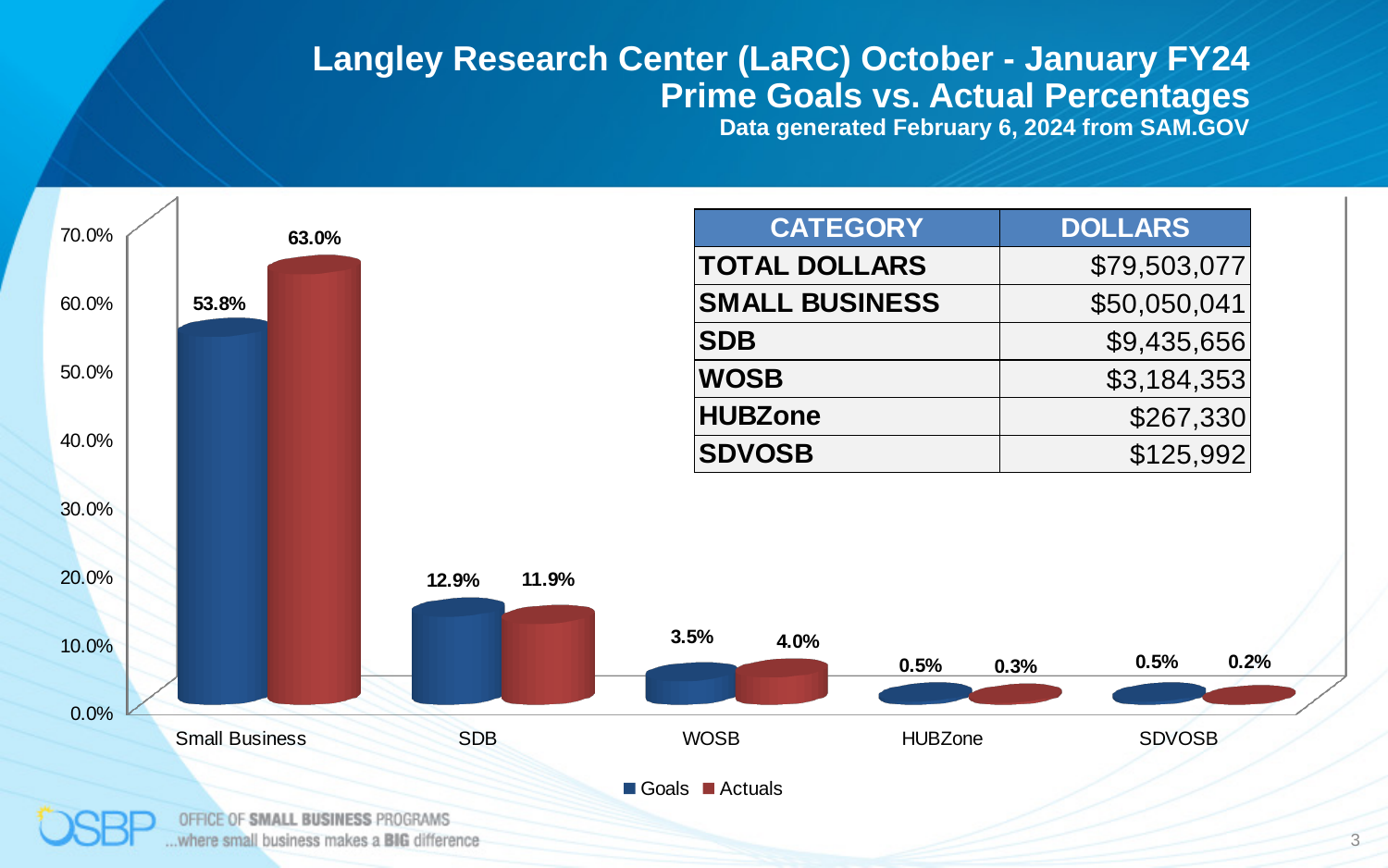
What is the Goals value for HUBZone? 0.5% How many categories are shown on the x axis? 5 How many series does the legend list? 2 What is the Actuals value for SDB? 11.9% Which category has the highest Actuals value? Small Business What is the difference between the Actuals and Goals values for Small Business? 9.2% What is the Actuals value for WOSB? 4.0% Which is larger for SDB, the Goals value or the Actuals value? Goals What kind of chart is shown on the slide? bar chart Is the Actuals value for Small Business greater or less than 60.0%? greater Which category has the lowest Actuals value? SDVOSB What is the Goals value for Small Business? 53.8%